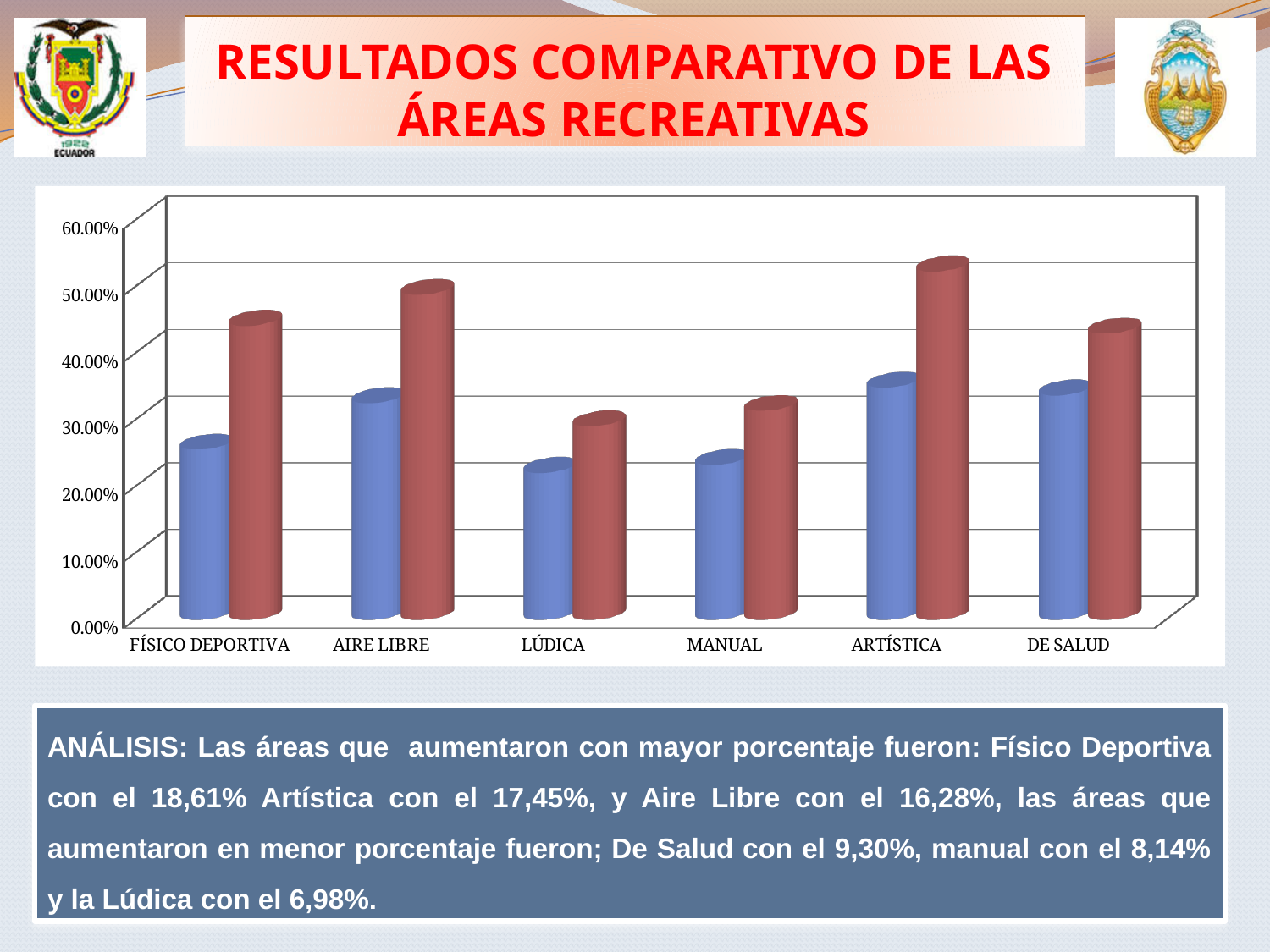
Is the red bar for AIRE LIBRE greater or less than 40.00%? greater What kind of chart is shown on the slide? bar chart Which category has the shortest red bar? LÚDICA How many categories are shown along the x axis of the chart? 6 Which is taller, the red bar for DE SALUD or the red bar for LÚDICA? DE SALUD Is the blue bar for LÚDICA greater or less than 30.00%? less Is the red bar for ARTÍSTICA greater or less than 50.00%? greater Which category has the tallest red bar? ARTÍSTICA How many bars are plotted for each category in the chart? 2 What is the highest value shown on the vertical axis of the chart? 60.00% For MANUAL, which bar is taller, the blue bar or the red bar? the red bar